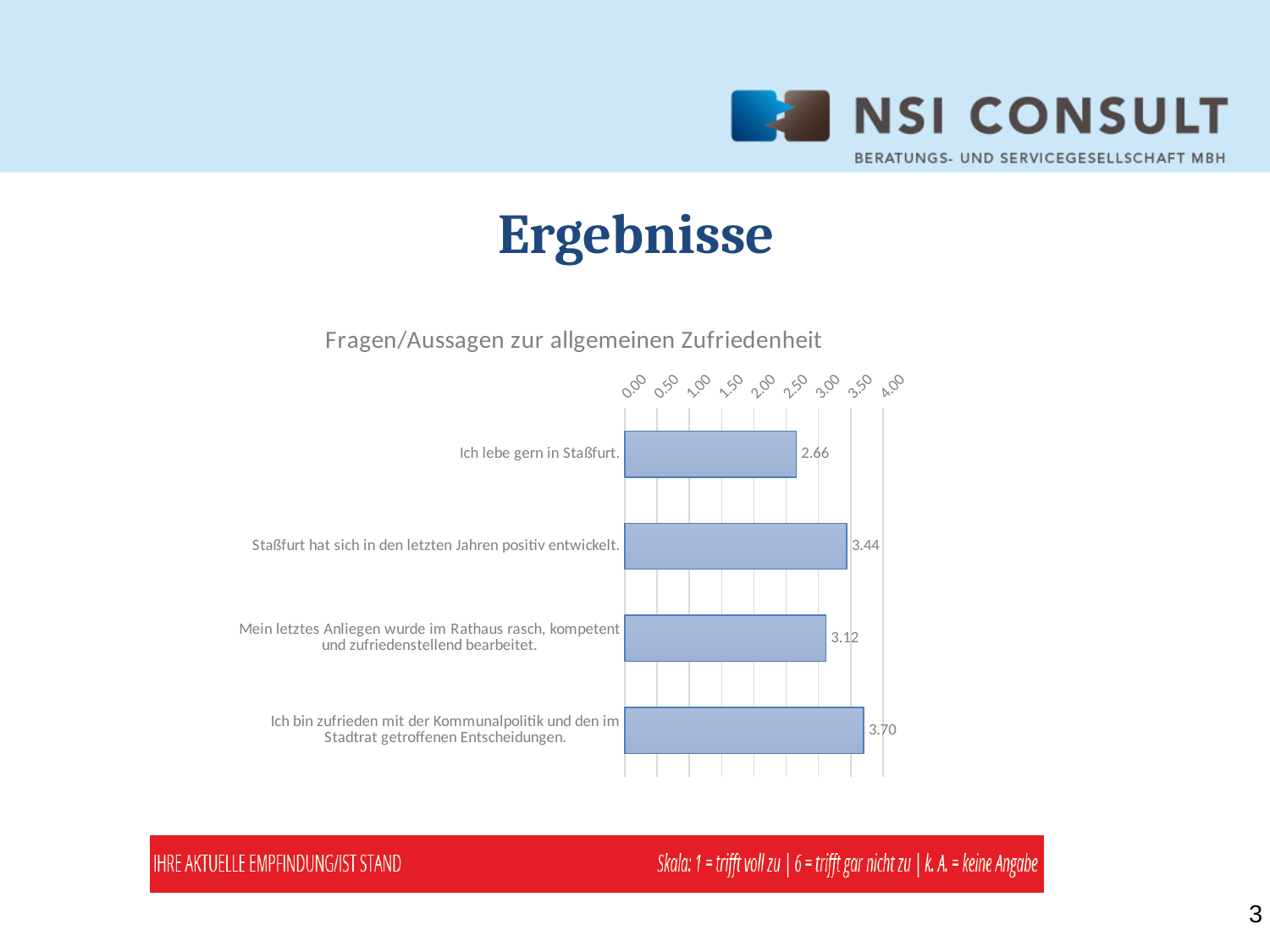
Which statement has the highest value? Ich bin zufrieden mit der Kommunalpolitik und den im Stadtrat getroffenen Entscheidungen. What is the difference between the values for "Ich bin zufrieden mit der Kommunalpolitik und den im Stadtrat getroffenen Entscheidungen." and "Ich lebe gern in Staßfurt."? 1.04 What is the title of the chart? Fragen/Aussagen zur allgemeinen Zufriedenheit How many statements are shown in the chart? 4 What is the value for "Ich bin zufrieden mit der Kommunalpolitik und den im Stadtrat getroffenen Entscheidungen."? 3.70 What kind of chart is shown on the slide? bar chart Is the value for "Ich lebe gern in Staßfurt." greater or less than 3.00? less What is the value for "Staßfurt hat sich in den letzten Jahren positiv entwickelt."? 3.44 Which has a larger value: "Staßfurt hat sich in den letzten Jahren positiv entwickelt." or "Mein letztes Anliegen wurde im Rathaus rasch, kompetent und zufriedenstellend bearbeitet."? Staßfurt hat sich in den letzten Jahren positiv entwickelt. What is the value for "Mein letztes Anliegen wurde im Rathaus rasch, kompetent und zufriedenstellend bearbeitet."? 3.12 What is the value for "Ich lebe gern in Staßfurt."? 2.66 Which statement has the lowest value? Ich lebe gern in Staßfurt.